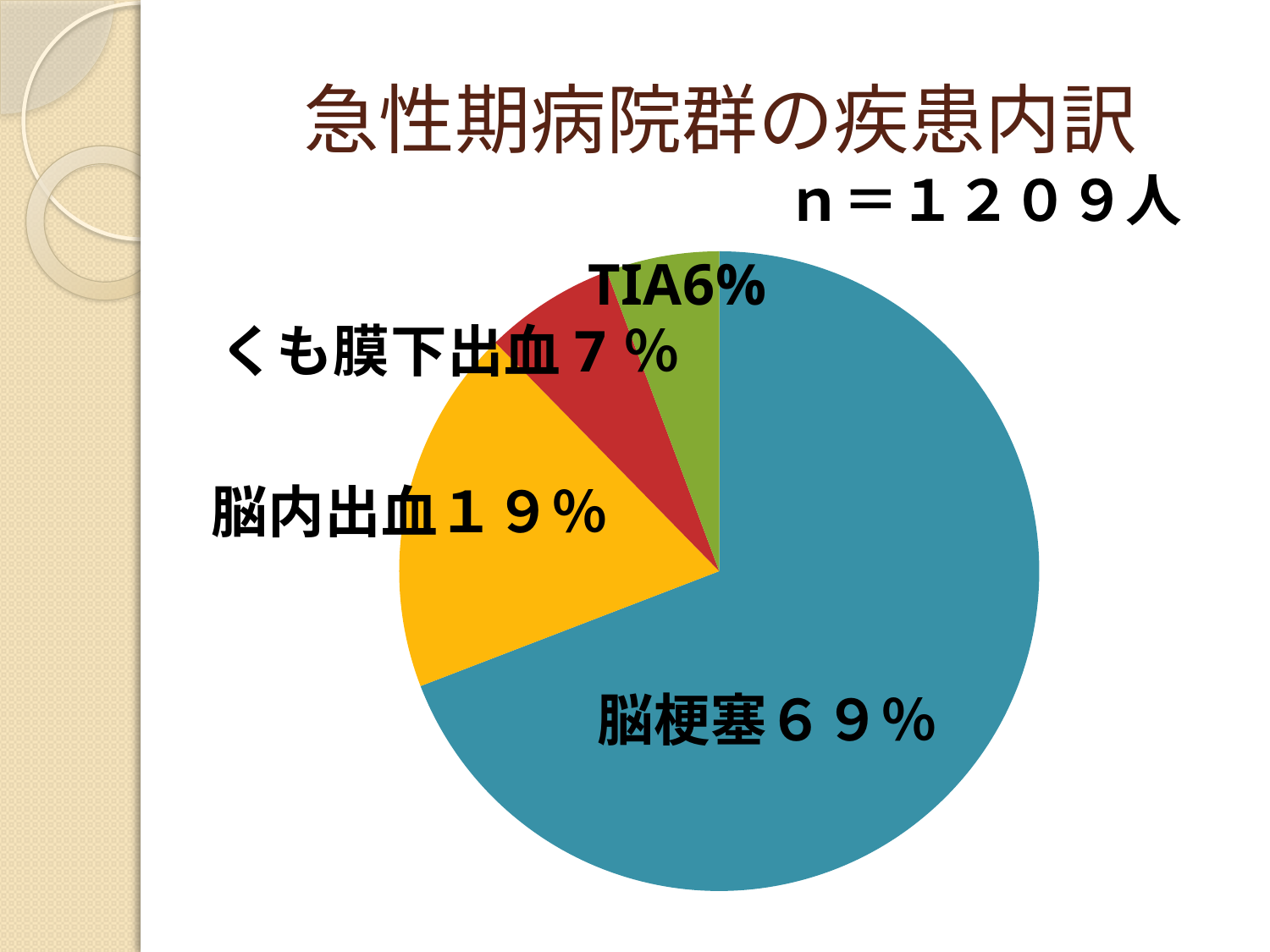
How many slices does the pie chart have? 4 Which category has the smallest slice of the pie? TIA What share of the pie does 脳梗塞 account for? ６９％ What share of the pie does 脳内出血 account for? １９％ What share of the pie does TIA account for? 6% What kind of chart is shown on the slide? pie chart Which category has the largest slice of the pie? 脳梗塞 What is the title of the chart? 急性期病院群の疾患内訳 What is the sample size (n) shown on the slide? １２０９人 Which is larger, the share for くも膜下出血 or the share for TIA? くも膜下出血 What is the difference in percentage points between 脳梗塞 and 脳内出血? 50